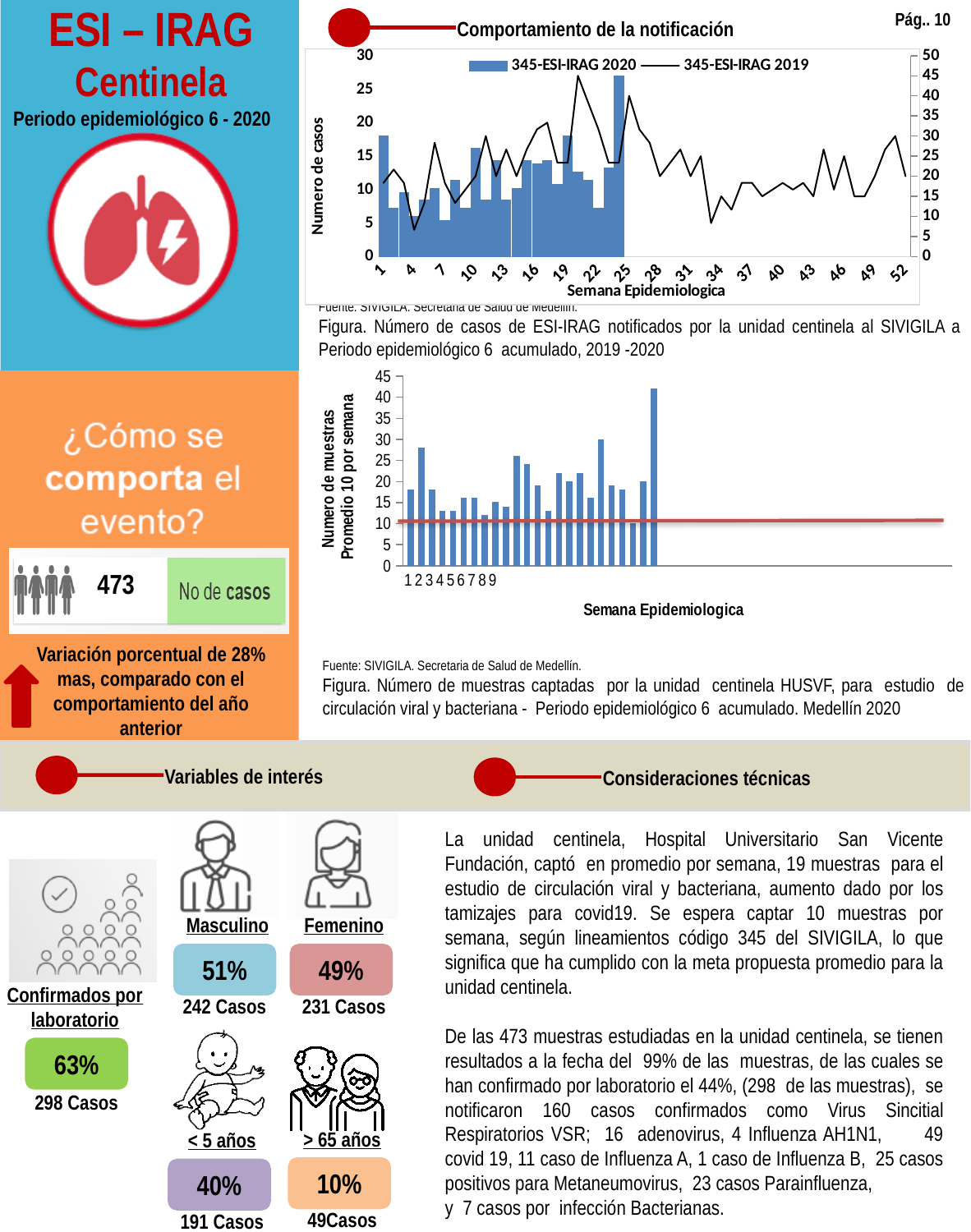
In the top chart 'Comportamiento de la notificación', how many series does the legend list? 2 In the top chart 'Comportamiento de la notificación', what are the two series named in the legend? 345-ESI-IRAG 2020 and 345-ESI-IRAG 2019 In the top chart 'Comportamiento de la notificación', at which epidemiological week is the 345-ESI-IRAG 2020 bar highest? 24 In the top chart 'Comportamiento de la notificación', which is larger for 345-ESI-IRAG 2020: the bar for week 1 or the bar for week 2? week 1 In the bottom chart of samples per week, is the value for week 2 greater or less than 20? greater In the bottom chart of samples per week, which is larger: the bar for week 1 or the bar for week 2? week 2 In the top chart 'Comportamiento de la notificación', which series is drawn as a line rather than bars? 345-ESI-IRAG 2019 In the bottom chart of samples per week, is the tallest bar greater or less than 35? greater In the bottom chart of samples per week, at what value on the y axis is the red horizontal line drawn? 10 What kind of chart is the bottom chart showing the number of samples per epidemiological week? bar chart